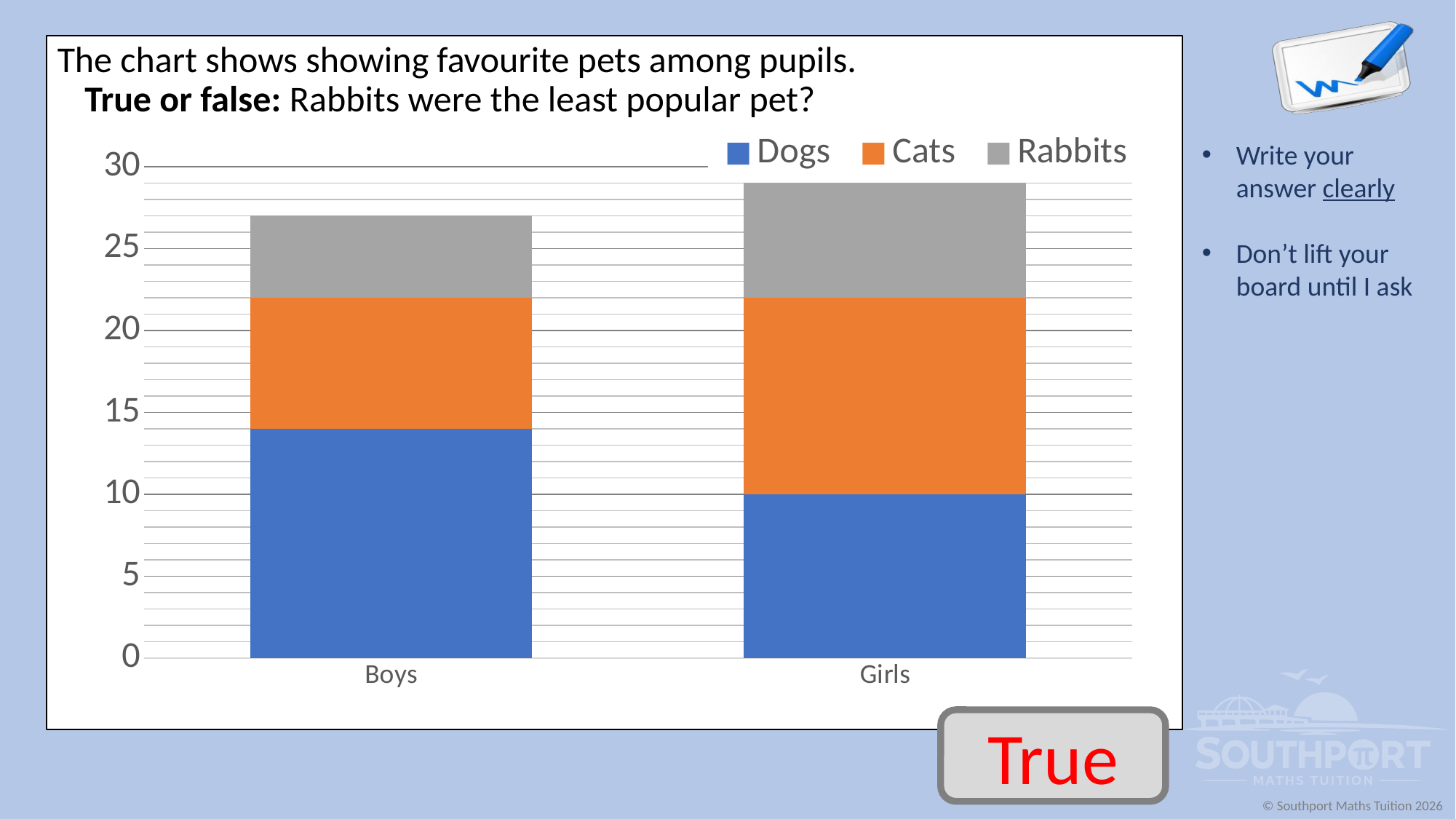
Is the total height of the Boys bar greater or less than 25? greater What is the value for Dogs in the Girls bar? 10 Which category has the larger Cats value, Boys or Girls? Girls Which series forms the bottom segment of each stacked bar? Dogs Which stacked bar is taller overall, Boys or Girls? Girls How many series does the legend list? 3 Which series is shown in grey in the legend? Rabbits How many categories are shown on the x axis? 2 Is the total height of the Girls bar greater or less than 30? less Is the value for Dogs in the Boys bar greater or less than 10? greater Which category has the larger Dogs value, Boys or Girls? Boys What kind of chart is shown on the slide? bar chart